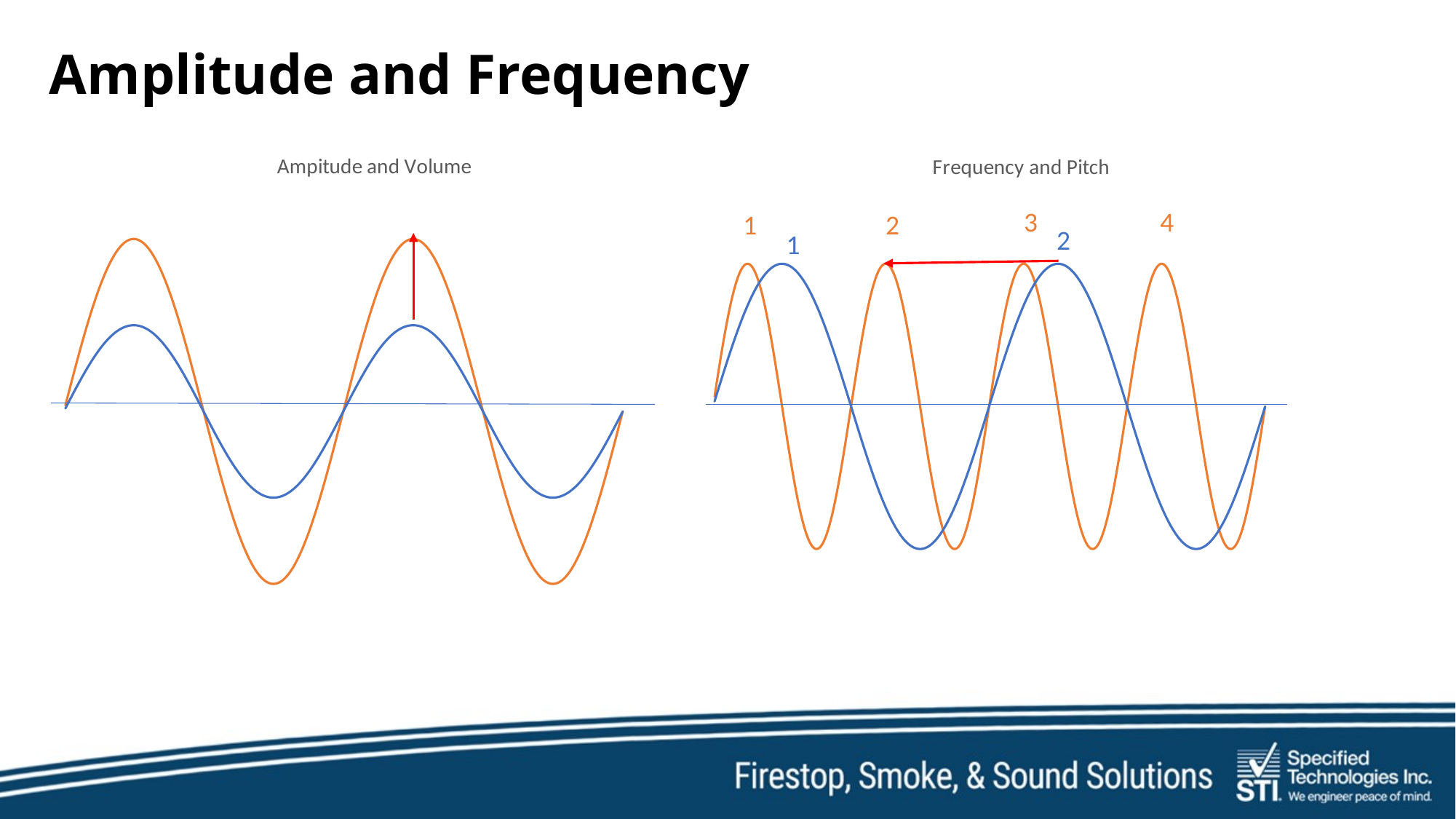
In the "Frequency and Pitch" chart, which line has more peaks, the orange line or the blue line? orange What kind of chart is the "Ampitude and Volume" chart? line chart What is the title of the chart on the right of the slide? Frequency and Pitch In the "Ampitude and Volume" chart, which line has the larger amplitude, the orange line or the blue line? orange In the "Frequency and Pitch" chart, how many peaks of the blue line are numbered? 2 What is the title of the chart on the left of the slide? Ampitude and Volume In the "Frequency and Pitch" chart, how many peaks of the orange line are numbered? 4 What kind of chart is the "Frequency and Pitch" chart? line chart How many lines are plotted in the "Ampitude and Volume" chart? 2